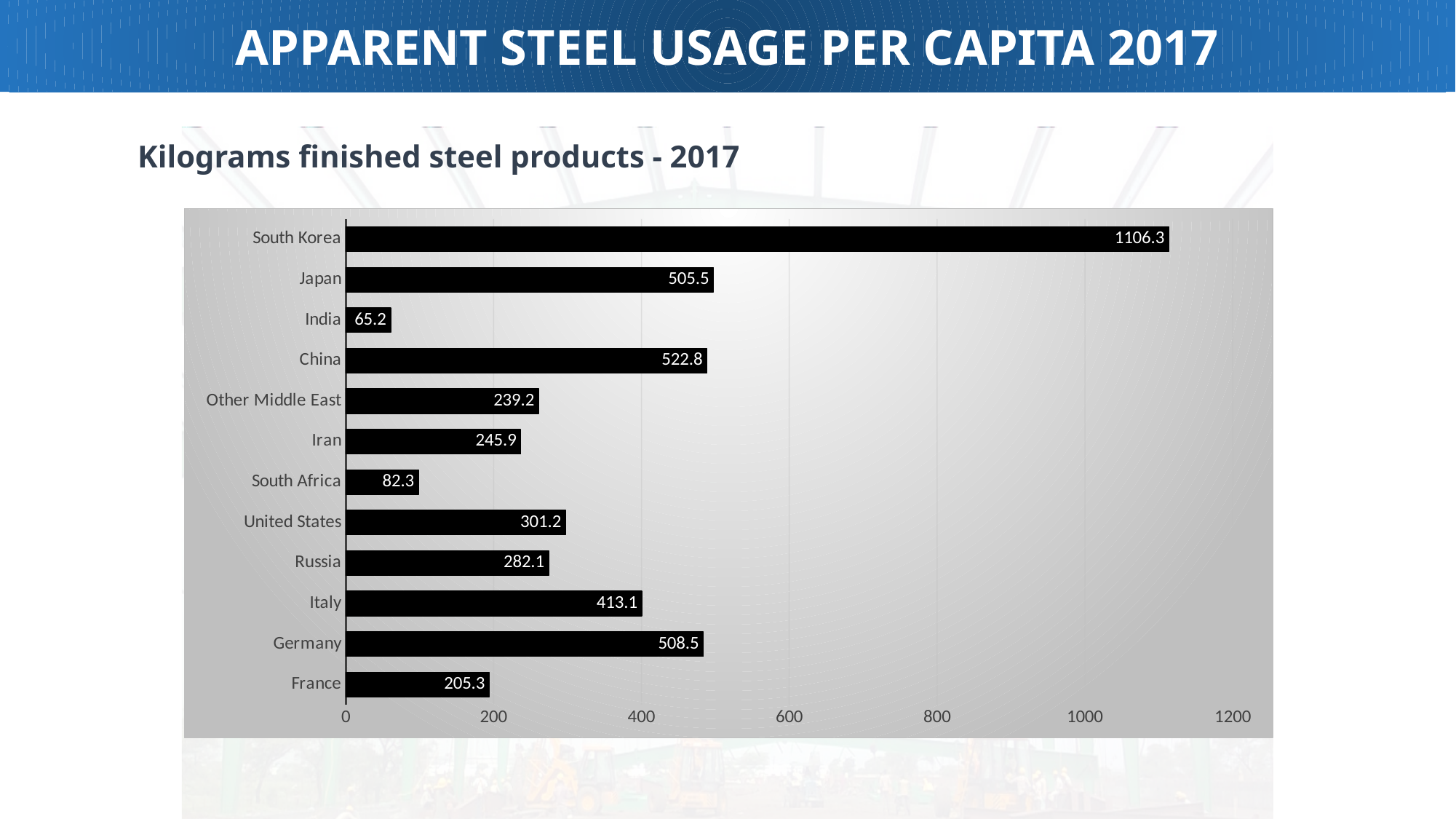
Which is larger, the value for Italy or the value for Iran? Italy Which category has the lowest value on the chart? India What kind of chart is shown on the slide? Bar chart What is the difference between the values for United States and Russia? 19.1 What is the value shown for Other Middle East? 239.2 What is the subtitle above the chart? Kilograms finished steel products - 2017 Which country has the highest apparent steel usage per capita? South Korea What is the value shown for Germany? 508.5 What is the apparent steel usage per capita for South Korea? 1106.3 How many countries or regions are shown on the chart? 12 What is the difference between the values for China and Japan? 17.3